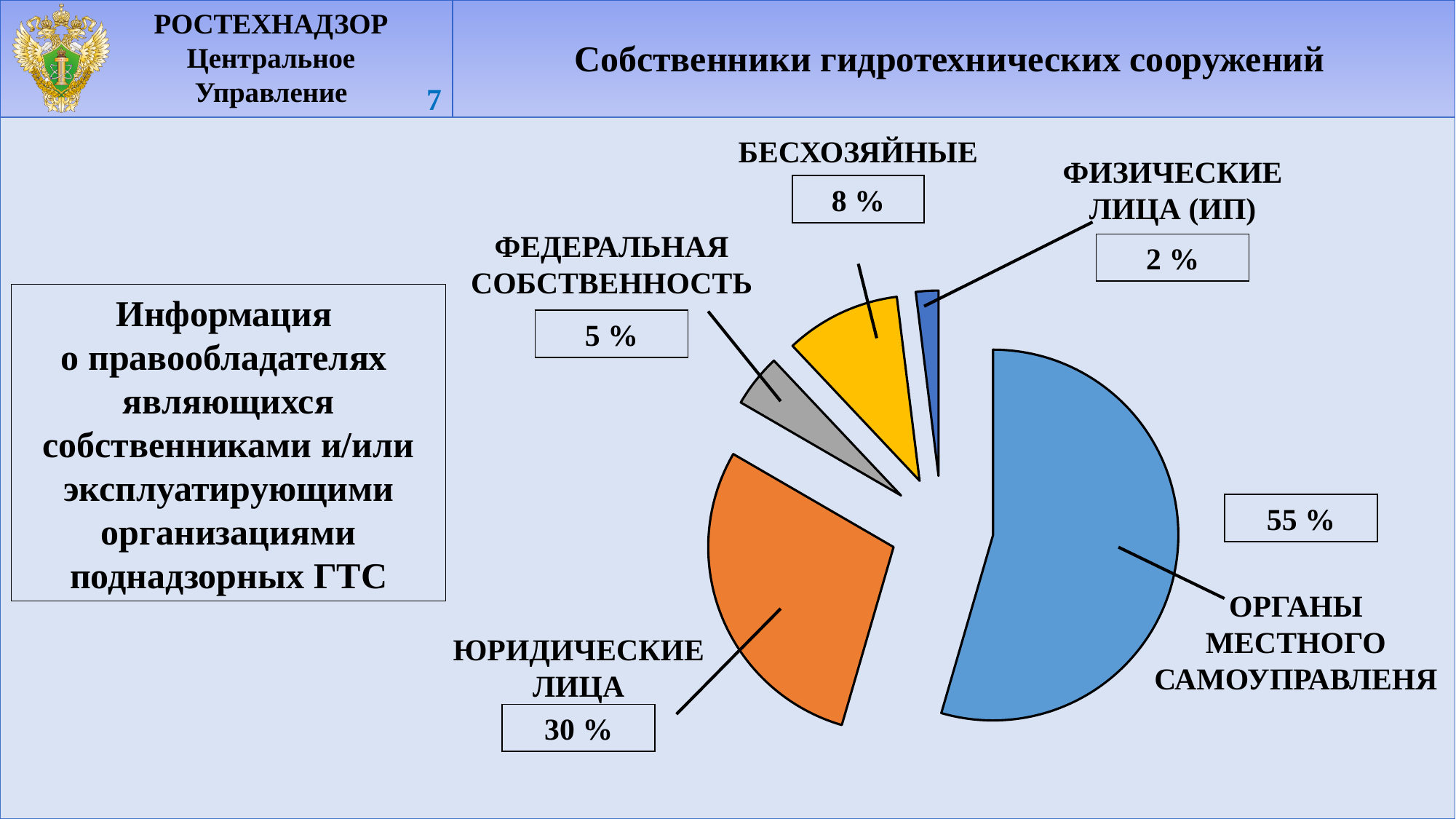
What is the difference in percentage points between ОРГАНЫ МЕСТНОГО САМОУПРАВЛЕНЯ and ЮРИДИЧЕСКИЕ ЛИЦА? 25 % What is the title of the chart on the slide? Собственники гидротехнических сооружений What share of the pie is labelled for ФЕДЕРАЛЬНАЯ СОБСТВЕННОСТЬ? 5 % What share of the pie is labelled for ЮРИДИЧЕСКИЕ ЛИЦА? 30 % Which category has the largest slice of the pie? ОРГАНЫ МЕСТНОГО САМОУПРАВЛЕНЯ What kind of chart is shown on the slide? Pie chart What share of the pie is labelled for БЕСХОЗЯЙНЫЕ? 8 % How many slices does the pie chart have? 5 Which is larger, the share for БЕСХОЗЯЙНЫЕ or the share for ФЕДЕРАЛЬНАЯ СОБСТВЕННОСТЬ? БЕСХОЗЯЙНЫЕ Which category has the smallest slice of the pie? ФИЗИЧЕСКИЕ ЛИЦА (ИП) What share of the pie is labelled for ОРГАНЫ МЕСТНОГО САМОУПРАВЛЕНЯ? 55 % What share of the pie is labelled for ФИЗИЧЕСКИЕ ЛИЦА (ИП)? 2 %